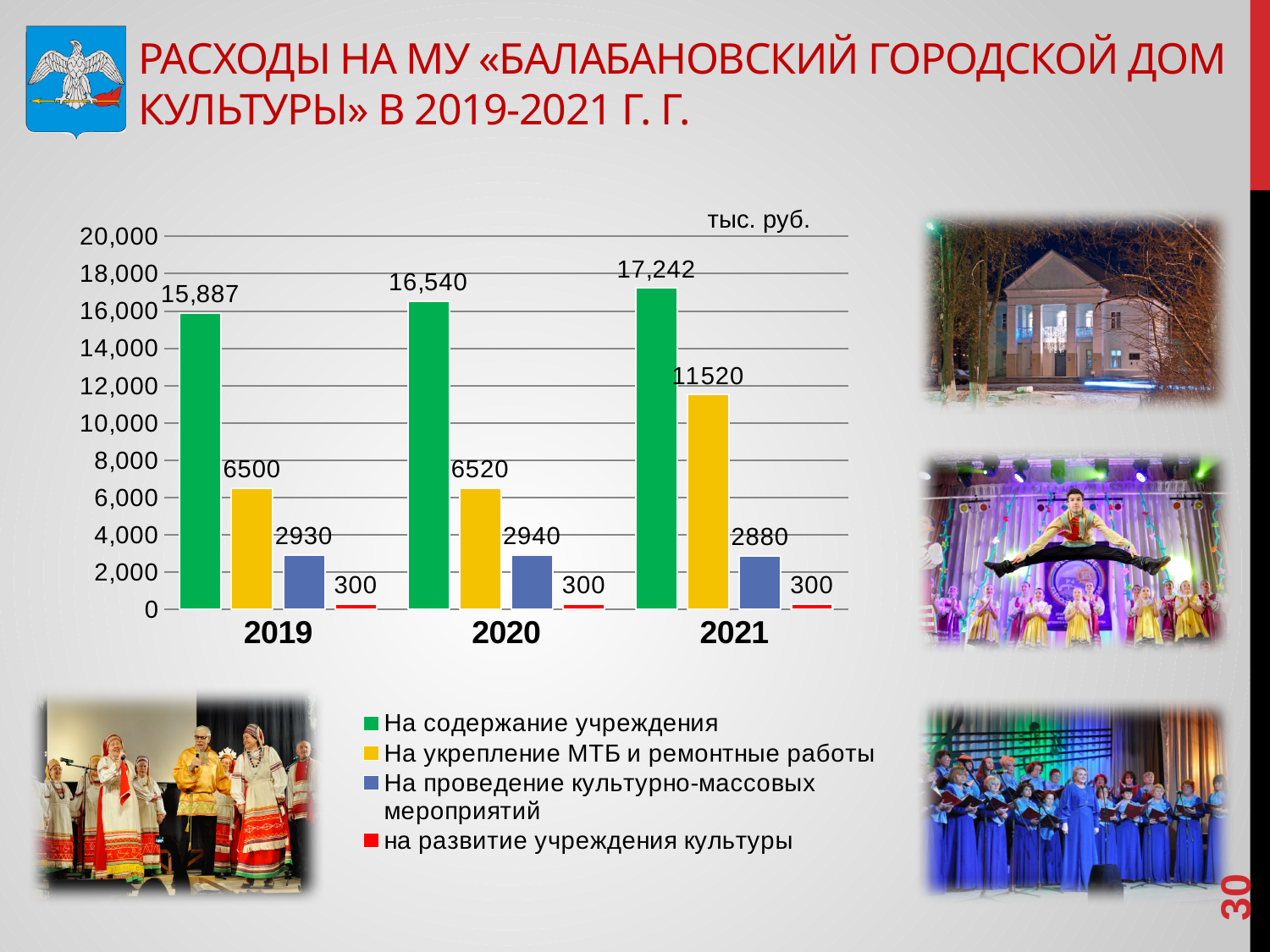
How many years (categories) are shown on the x axis? 3 In which year is the value for «На содержание учреждения» the highest? 2021 What is the value for «На содержание учреждения» in 2021? 17,242 What is the value for «на развитие учреждения культуры» in 2021? 300 Does the value for «На содержание учреждения» rise or fall from 2019 to 2021? rise What is the value for «На укрепление МТБ и ремонтные работы» in 2020? 6520 Which is larger: «На содержание учреждения» in 2019 or in 2020? 2020 What kind of chart is shown on the slide? bar chart What is the difference between the «На укрепление МТБ и ремонтные работы» values for 2021 and 2020? 5000 How many series does the legend list? 4 What is the value for «На проведение культурно-массовых мероприятий» in 2019? 2930 In which year is the value for «На проведение культурно-массовых мероприятий» the lowest? 2021